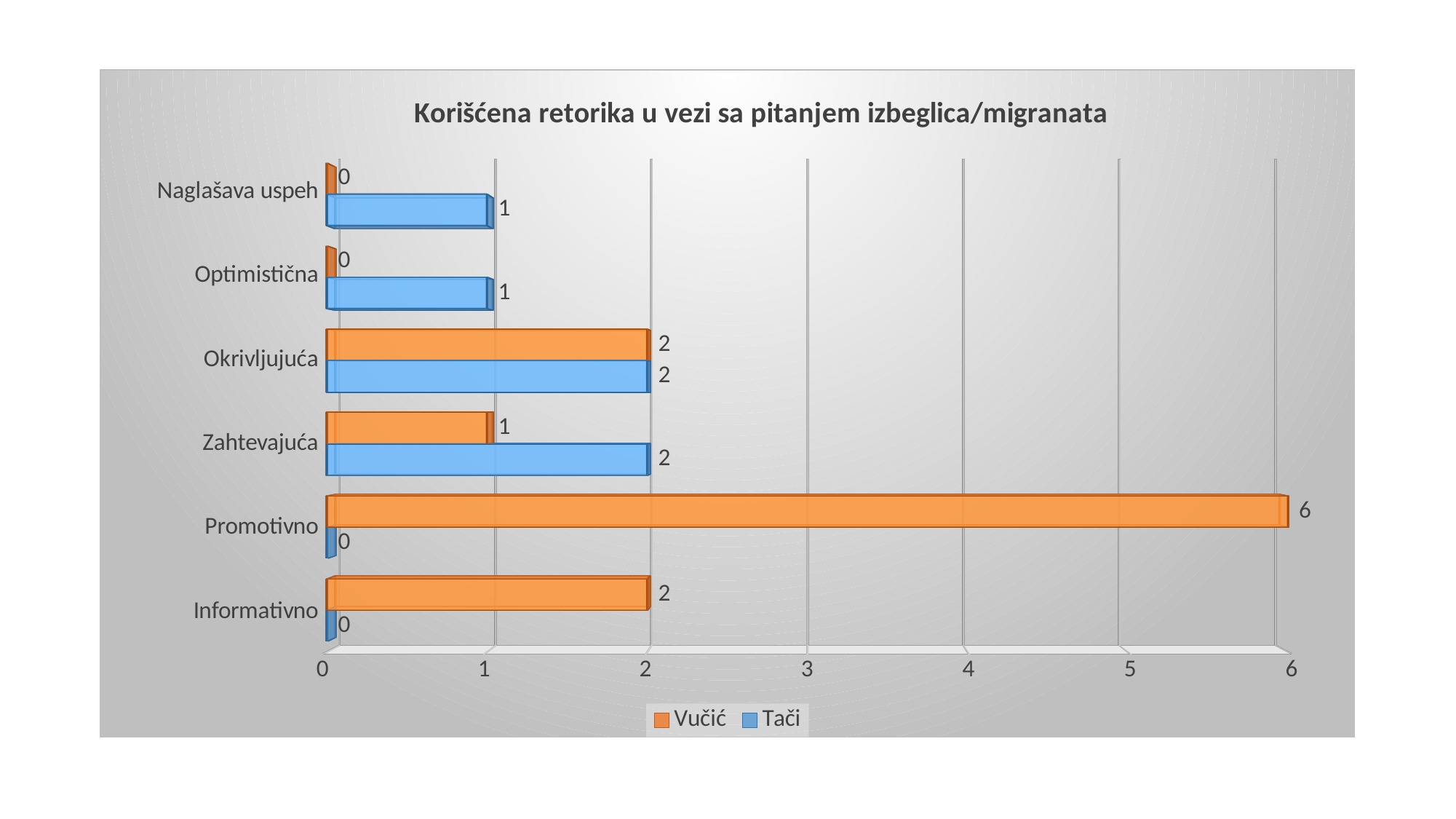
What is the value for Tači in the Naglašava uspeh category? 1 What is the difference between the Vučić and Tači values in the Zahtevajuća category? 1 What is the title of the chart? Korišćena retorika u vezi sa pitanjem izbeglica/migranata What is the value for Tači in the Zahtevajuća category? 2 How many categories are shown on the chart? 6 What is the value for Vučić in the Promotivno category? 6 In the Optimistična category, which series has the larger value, Vučić or Tači? Tači Which category has the highest value for Vučić? Promotivno How many series does the legend list? 2 What is the value for Vučić in the Informativno category? 2 What kind of chart is shown on the slide? Bar chart What is the difference between the Vučić value for Promotivno and the Vučić value for Informativno? 4